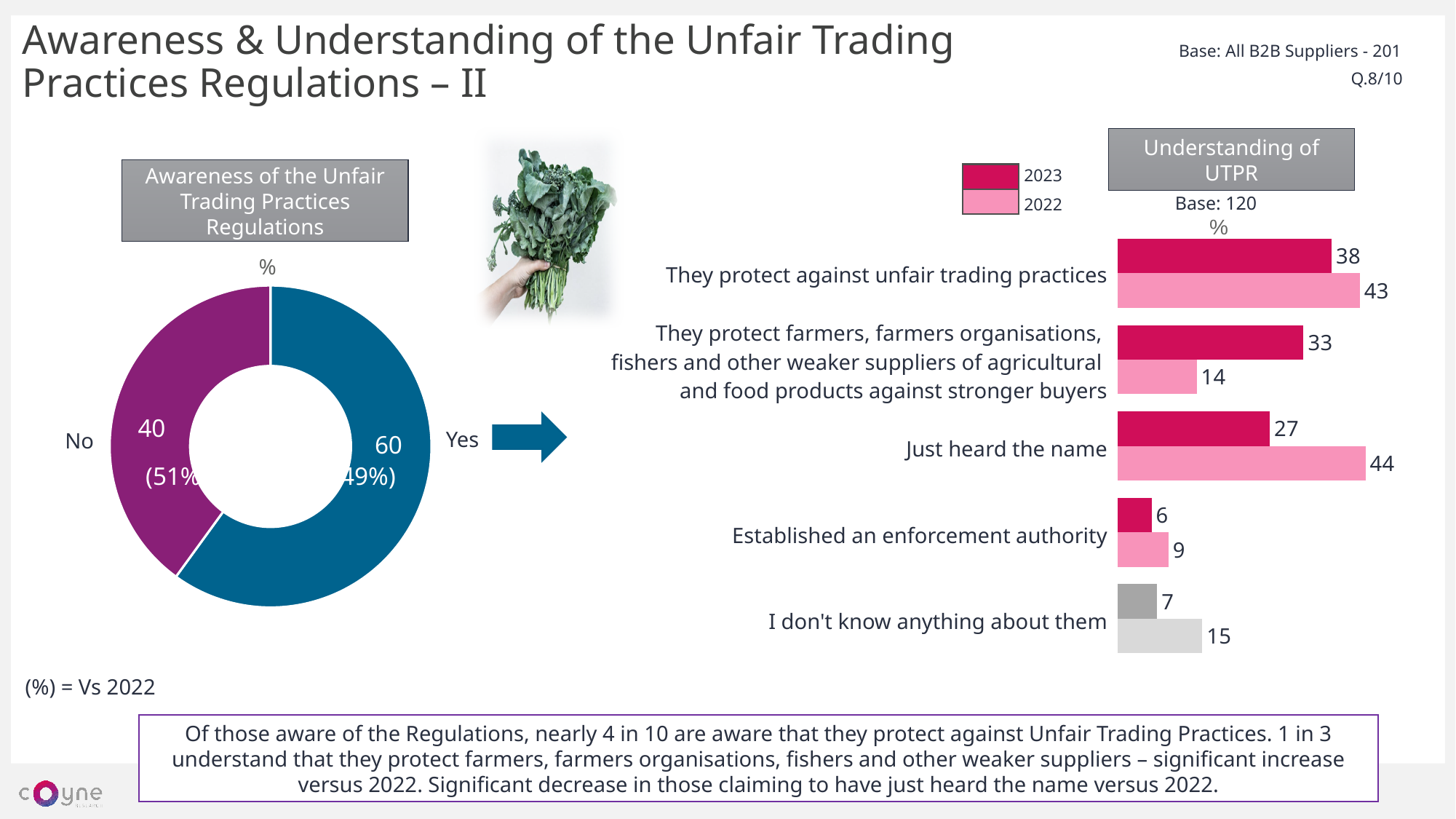
What kind of chart is the 'Awareness of the Unfair Trading Practices Regulations' chart? Donut (pie) chart In the 'Understanding of UTPR' chart, what is the 2022 value for 'Just heard the name'? 44 In the 'Understanding of UTPR' chart, which category has the lowest 2023 value? Established an enforcement authority In the 'Awareness of the Unfair Trading Practices Regulations' chart, what percentage answered Yes? 60 In the 'Understanding of UTPR' chart, what is the difference between the 2022 and 2023 values for 'Just heard the name'? 17 In the 'Understanding of UTPR' chart, how many categories are shown? 5 In the 'Understanding of UTPR' chart, how many series does the legend list? 2 In the 'Understanding of UTPR' chart, what is the 2022 value for 'I don't know anything about them'? 15 In the 'Awareness of the Unfair Trading Practices Regulations' chart, what percentage answered No? 40 In the 'Understanding of UTPR' chart, what is the 2023 value for 'They protect against unfair trading practices'? 38 In the 'Understanding of UTPR' chart, which category has the highest 2023 value? They protect against unfair trading practices In the 'Awareness of the Unfair Trading Practices Regulations' chart, which answer has the larger share, Yes or No? Yes